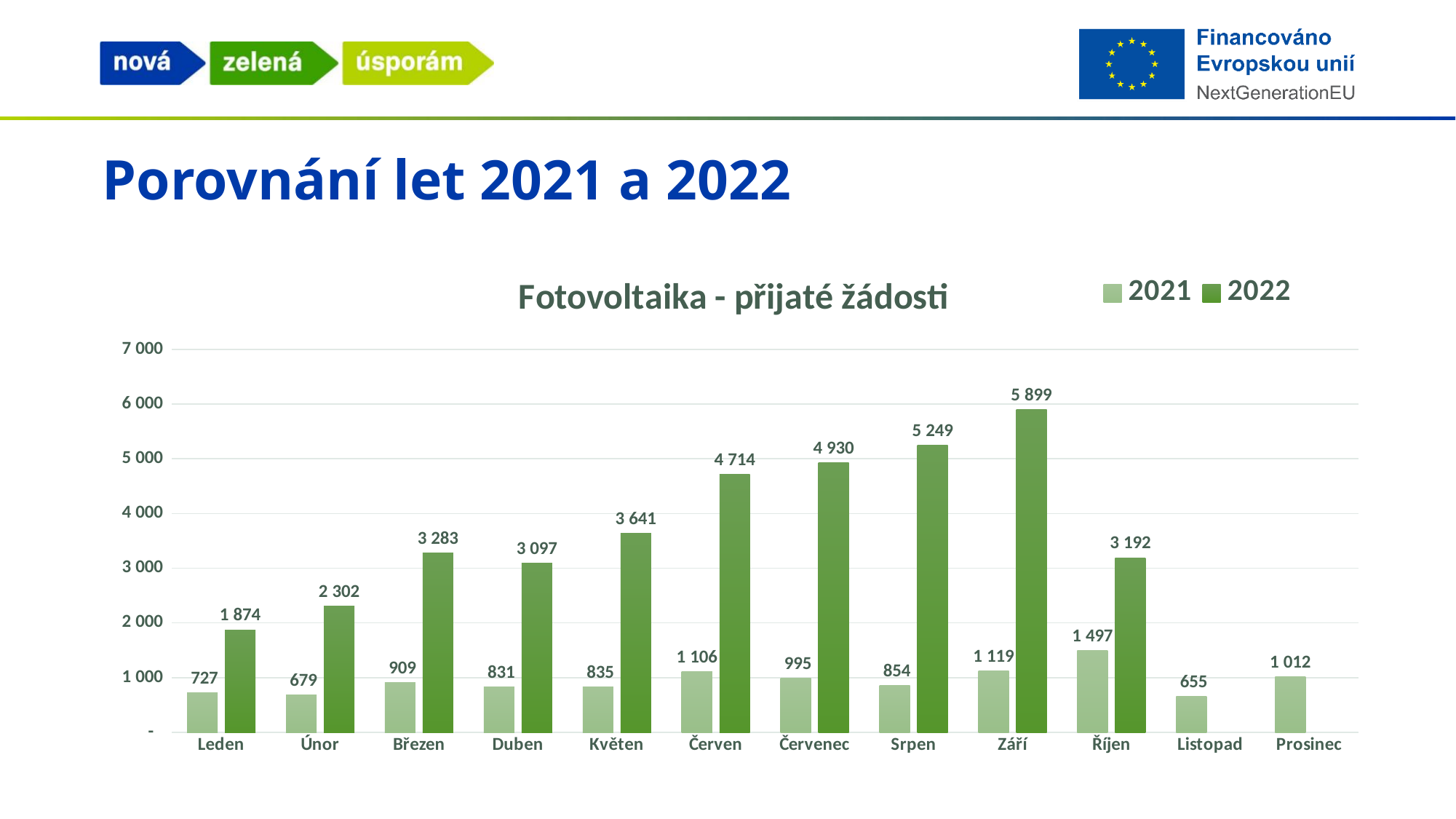
What is the title of the chart? Fotovoltaika - přijaté žádosti Which month has the highest value for the 2022 series? Září What is the value for 2022 in Duben? 3 097 What is the value for 2022 in Září? 5 899 What is the value for 2021 in Červen? 1 106 Does the 2022 series rise or fall from Květen to Září? Rise How many months are shown on the x axis? 12 Which month has the lowest value for the 2021 series? Listopad What kind of chart is shown on the slide? Bar chart How many series does the legend list? 2 What is the difference between the 2022 and 2021 values in Leden? 1 147 Which is larger: the 2021 value for Říjen or the 2021 value for Prosinec? Říjen